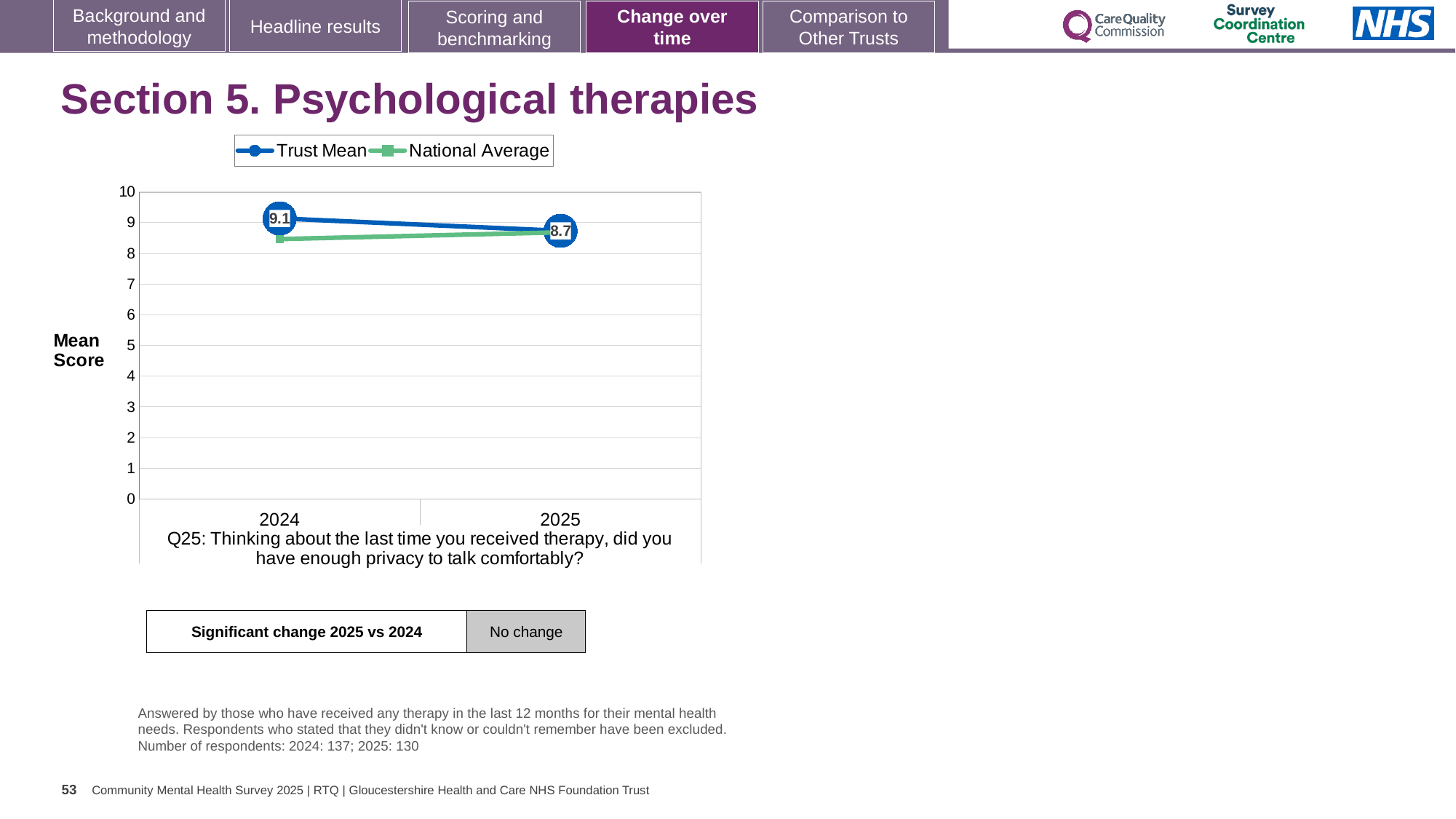
What is the Trust Mean value for 2025? 8.7 Does the Trust Mean rise or fall from 2024 to 2025? fall What is the label on the y axis of the chart? Mean Score Which year has the higher Trust Mean, 2024 or 2025? 2024 How many series does the legend list? 2 Is the National Average value for 2024 greater or less than 9? less How many years are shown on the x axis of the chart? 2 What kind of chart is shown on the slide? line chart In 2024, which is higher: the Trust Mean or the National Average? Trust Mean By how much did the Trust Mean change from 2024 to 2025? 0.4 Is the National Average value for 2024 greater or less than 8? greater What is the Trust Mean value for 2024? 9.1